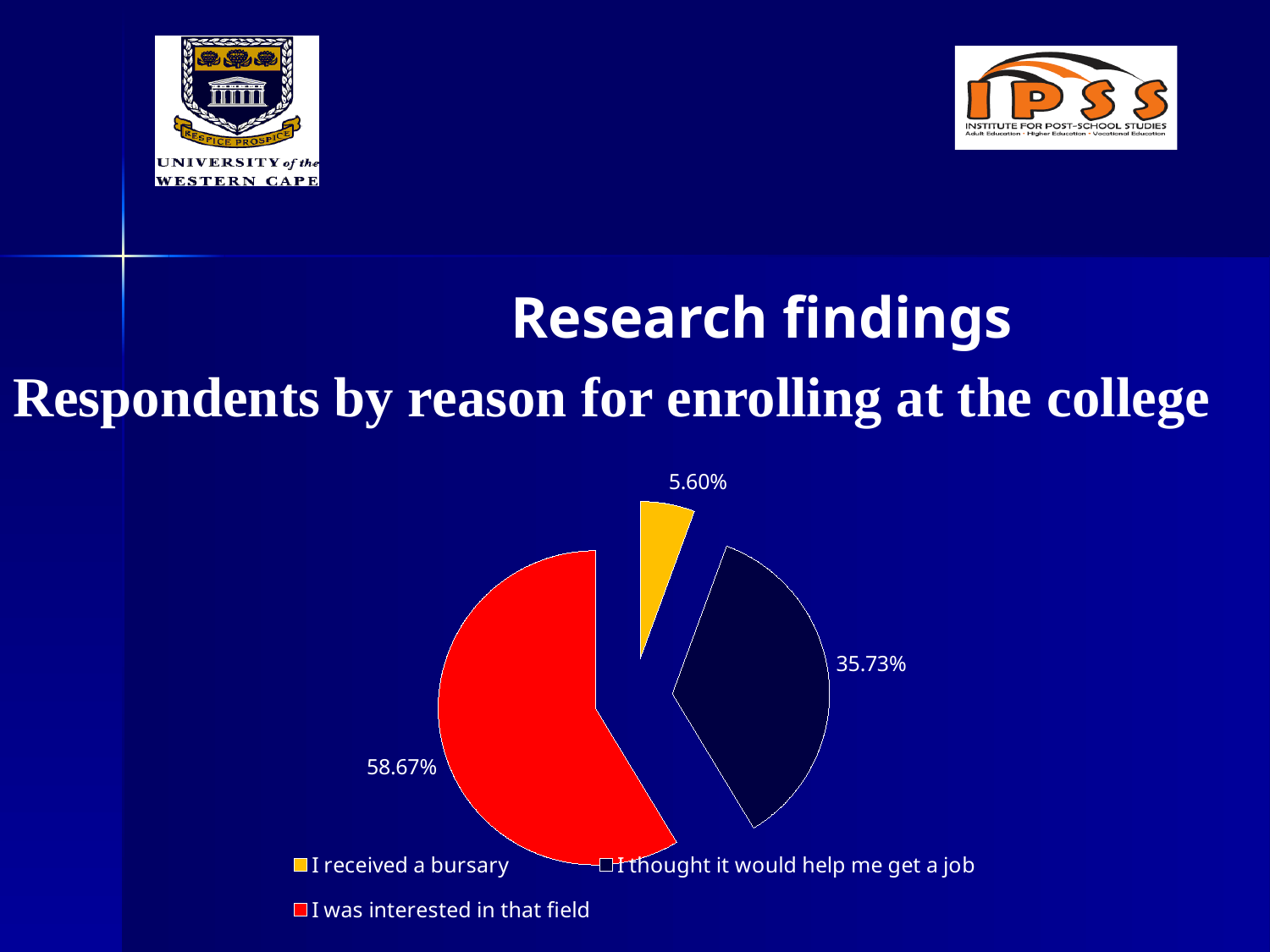
What percentage of respondents said they received a bursary? 5.60% What percentage of respondents said they thought it would help them get a job? 35.73% How many reasons for enrolling are shown in the pie chart? 3 What is the difference in percentage points between 'I thought it would help me get a job' and 'I received a bursary'? 30.13 Which reason for enrolling has the largest share of respondents? I was interested in that field What is the difference in percentage points between 'I was interested in that field' and 'I thought it would help me get a job'? 22.94 What colour is the slice for 'I received a bursary'? Yellow Which reason for enrolling has the smallest share of respondents? I received a bursary Which has a larger share: 'I thought it would help me get a job' or 'I received a bursary'? I thought it would help me get a job What type of chart is shown on the slide? Pie chart What is the title of the chart? Respondents by reason for enrolling at the college What percentage of respondents said they were interested in that field? 58.67%